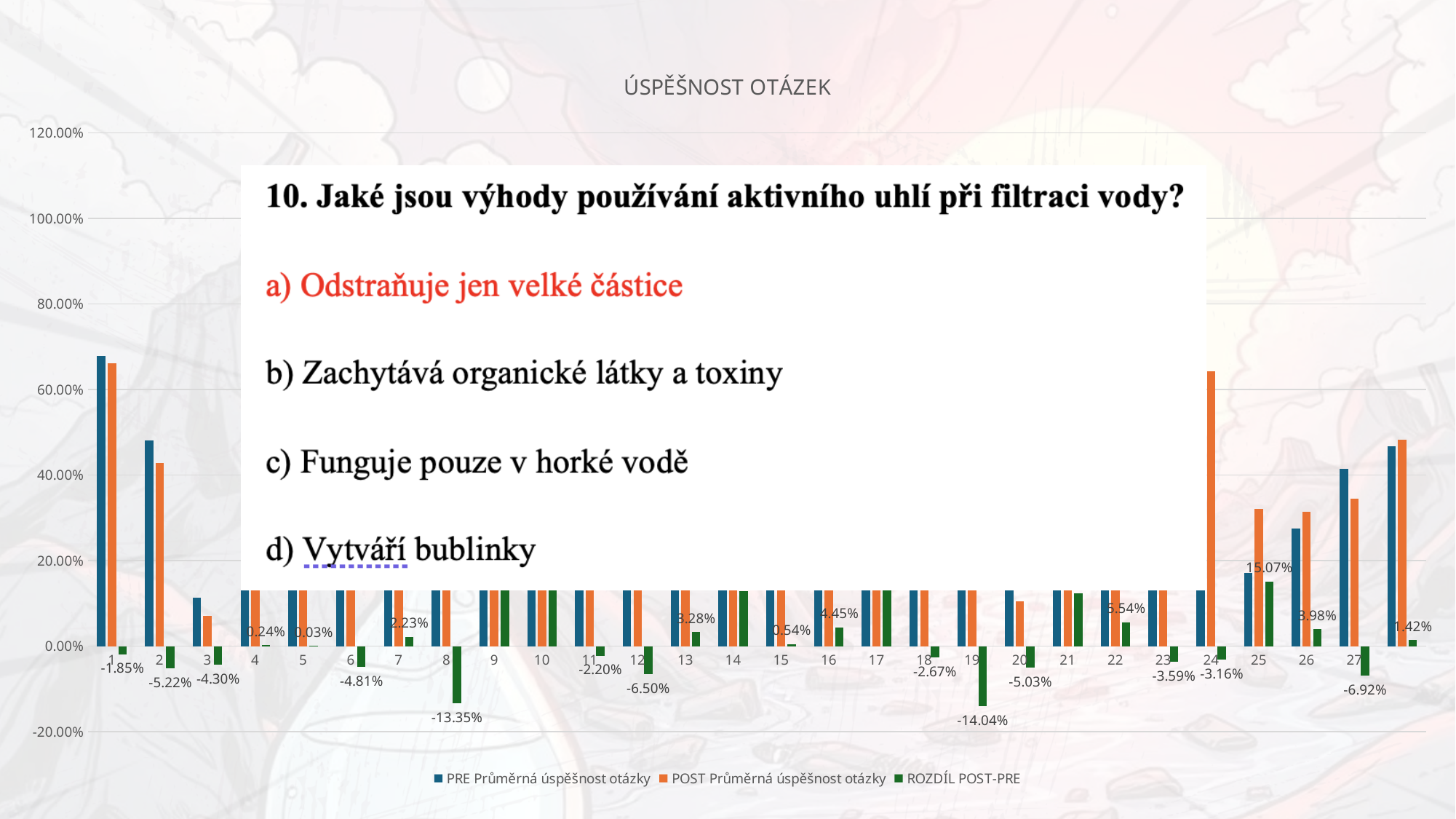
What is the ROZDÍL POST-PRE value for question 12? -6.50% How many series does the legend list? 3 What kind of chart is shown on the slide? bar chart What is the ROZDÍL POST-PRE value for question 19? -14.04% Is the POST Průměrná úspěšnost otázky value for question 24 greater or less than 60%? greater What is the ROZDÍL POST-PRE value for question 8? -13.35% For question 2, which is larger: the PRE value or the POST value? PRE Is the PRE Průměrná úspěšnost otázky value for question 1 greater or less than 60%? greater What is the ROZDÍL POST-PRE value for question 25? 15.07% Which question has the lowest ROZDÍL POST-PRE value? 19 What is the title of the chart? ÚSPĚŠNOST OTÁZEK